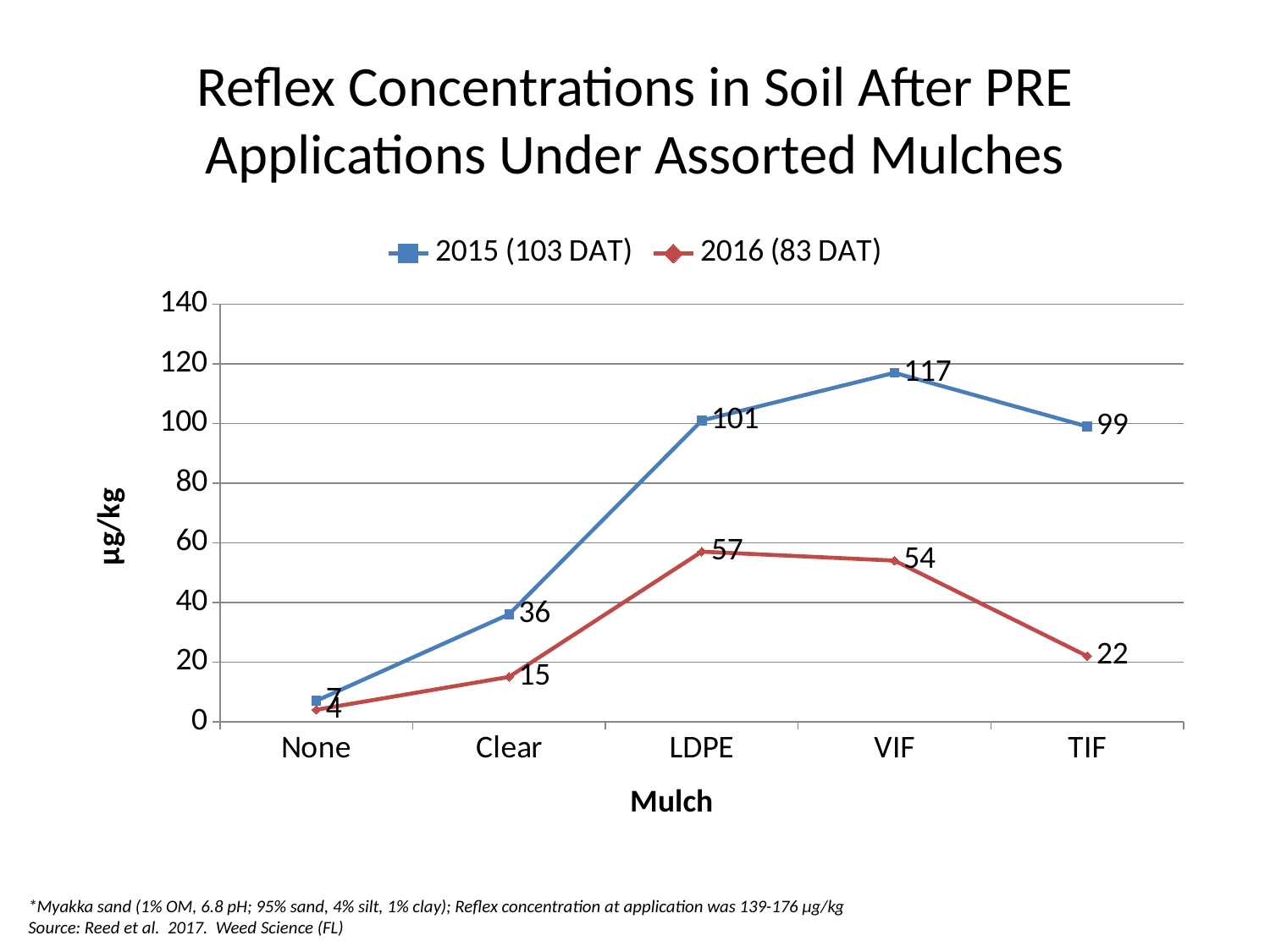
What is the label on the y axis? µg/kg What is the 2015 (103 DAT) value for VIF? 117 How many mulch categories are shown on the x axis? 5 Which mulch has the lowest 2016 (83 DAT) value? None Which mulch has the highest 2015 (103 DAT) value? VIF Which is larger for TIF: the 2015 (103 DAT) value or the 2016 (83 DAT) value? 2015 (103 DAT) What is the 2016 (83 DAT) value for LDPE? 57 What is the 2015 (103 DAT) value for Clear mulch? 36 What kind of chart is shown on the slide? line chart What is the difference between the 2015 (103 DAT) and 2016 (83 DAT) values for LDPE? 44 What is the 2016 (83 DAT) value for TIF? 22 How many series does the legend list? 2